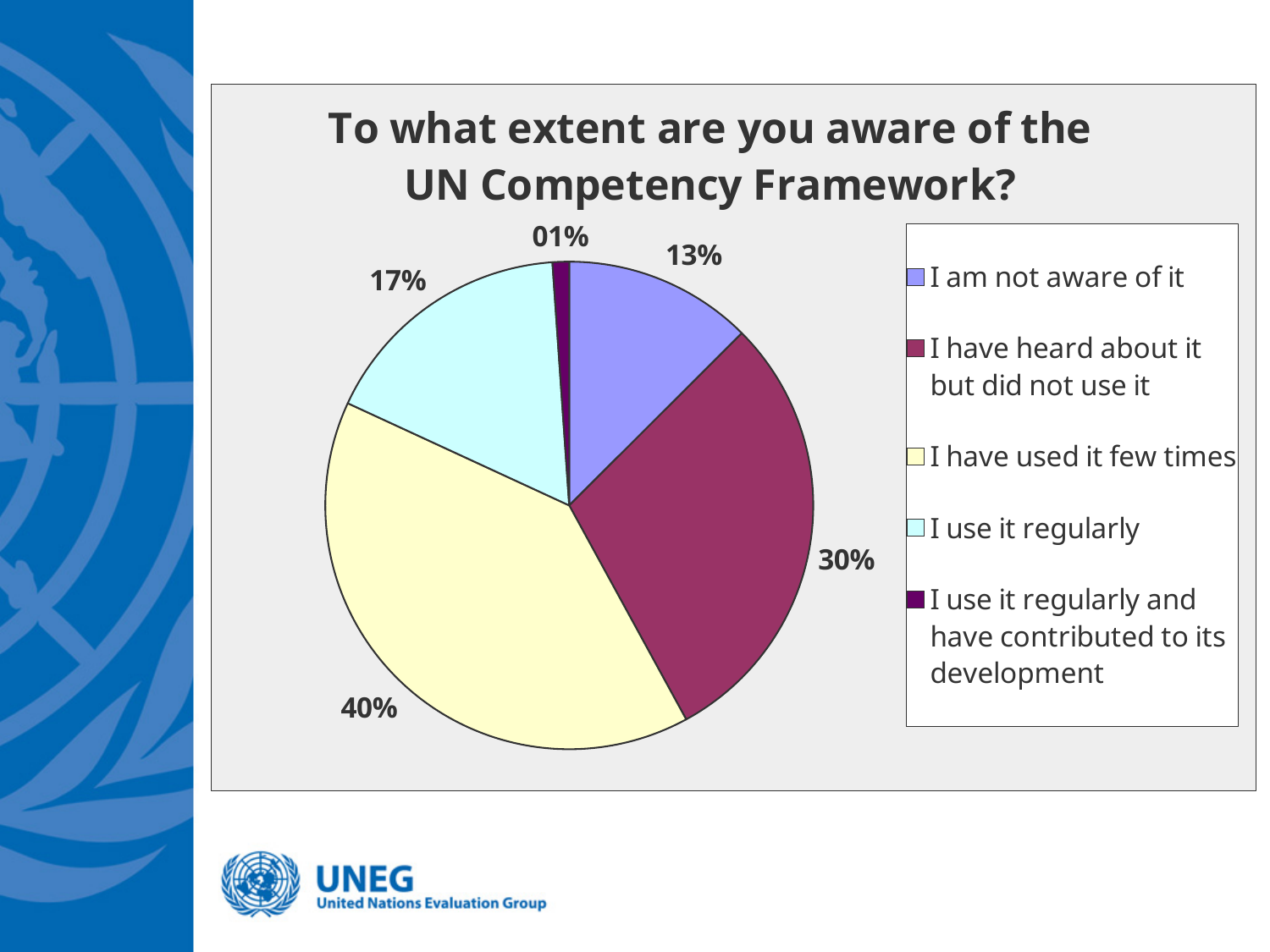
Which response has the largest share of the pie? I have used it few times How many categories does the legend list? 5 What share of respondents said "I have used it few times"? 40% Which is larger: the share for "I use it regularly" or the share for "I am not aware of it"? I use it regularly What kind of chart is shown on the slide? pie chart What is the title of the chart? To what extent are you aware of the UN Competency Framework? What share of respondents said "I use it regularly and have contributed to its development"? 01% What share of respondents said "I use it regularly"? 17% What share of respondents said "I am not aware of it"? 13% What share of respondents said "I have heard about it but did not use it"? 30% How many percentage points larger is the share for "I have used it few times" than for "I have heard about it but did not use it"? 10 Which response has the smallest share of the pie? I use it regularly and have contributed to its development